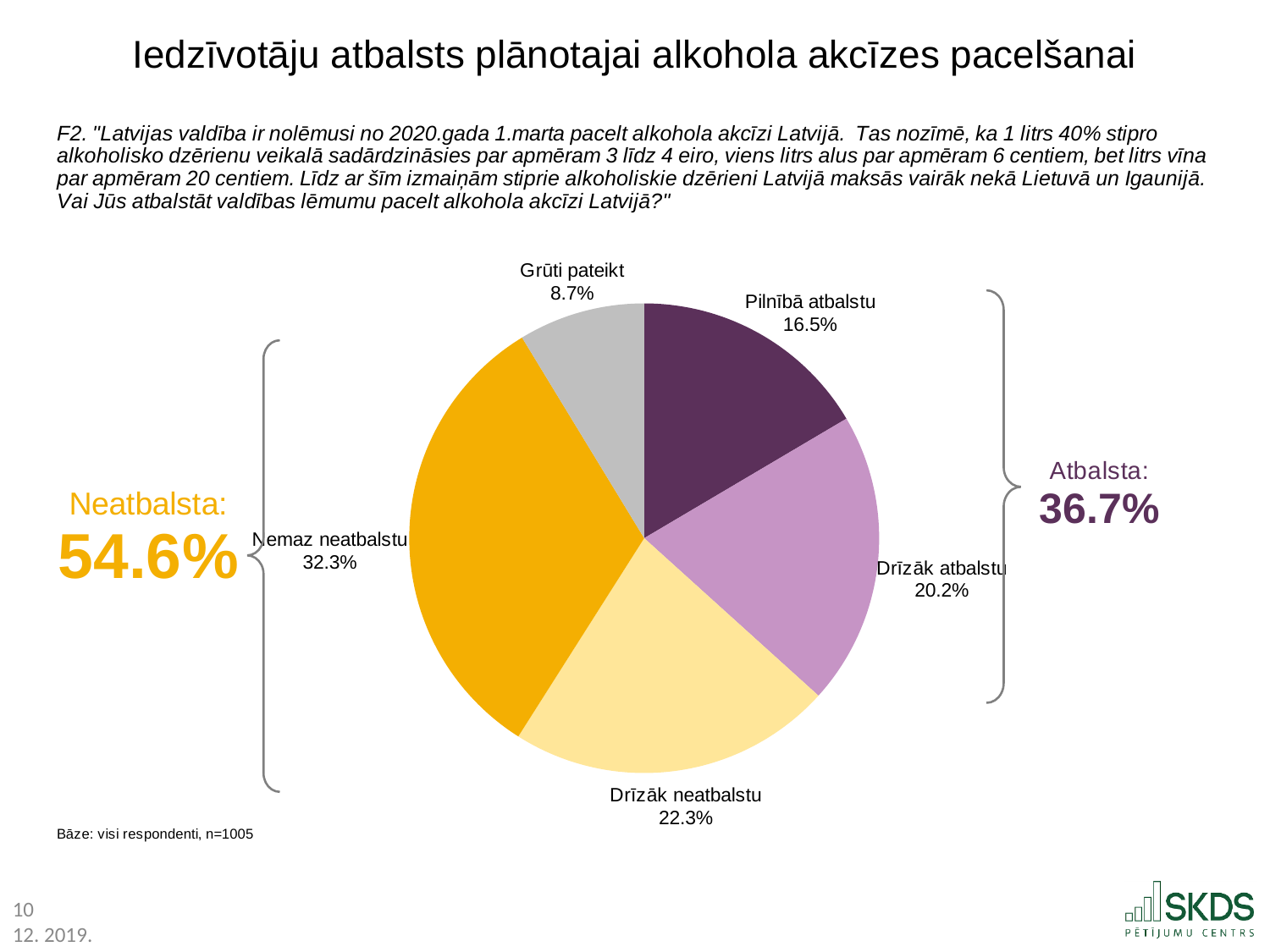
How many slices does the pie chart have? 5 What share of respondents answered "Grūti pateikt"? 8.7% What is the difference between the shares for "Drīzāk neatbalstu" and "Drīzāk atbalstu"? 2.1% What combined percentage is shown on the slide for "Neatbalsta"? 54.6% What share of respondents answered "Nemaz neatbalstu"? 32.3% What share of respondents answered "Drīzāk atbalstu"? 20.2% Which response has the smallest slice of the pie? Grūti pateikt What share of respondents answered "Pilnībā atbalstu"? 16.5% Which is larger, the share for "Nemaz neatbalstu" or the share for "Drīzāk neatbalstu"? Nemaz neatbalstu What combined percentage is shown on the slide for "Atbalsta"? 36.7% What kind of chart is shown on the slide? pie chart Which response has the largest slice of the pie? Nemaz neatbalstu